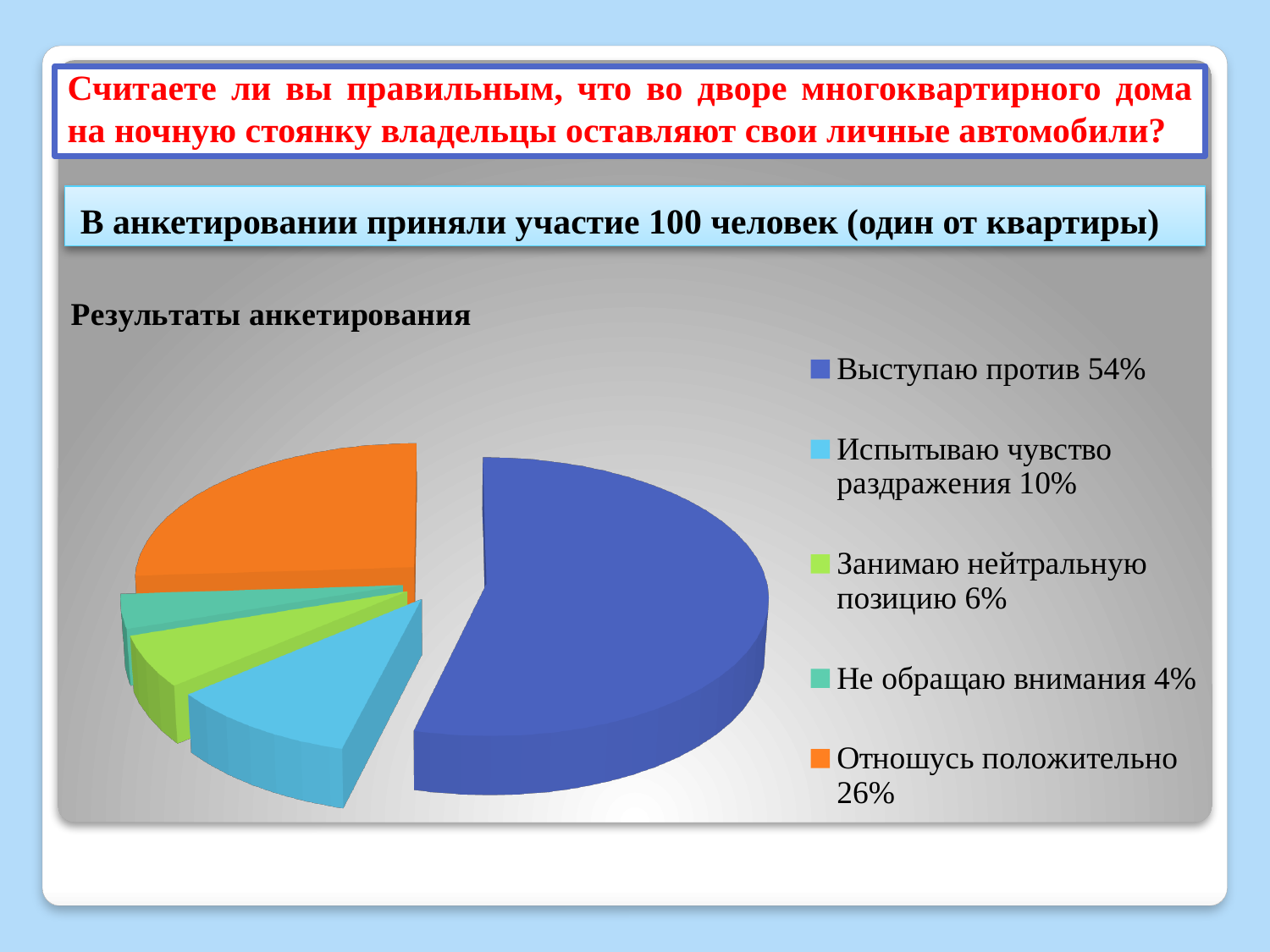
How many slices does the pie chart have? 5 What is the difference in percentage points between "Выступаю против" and "Отношусь положительно"? 28 What is the title of the chart? Результаты анкетирования What share of respondents chose "Выступаю против"? 54% Which is larger: the share for "Занимаю нейтральную позицию" or for "Испытываю чувство раздражения"? Испытываю чувство раздражения Which response has the largest share of the pie? Выступаю против Which response has the smallest share of the pie? Не обращаю внимания What share of respondents chose "Отношусь положительно"? 26% What kind of chart is shown on the slide? pie chart What share of respondents chose "Не обращаю внимания"? 4% Which colour represents "Отношусь положительно" in the pie chart? orange What share of respondents chose "Испытываю чувство раздражения"? 10%